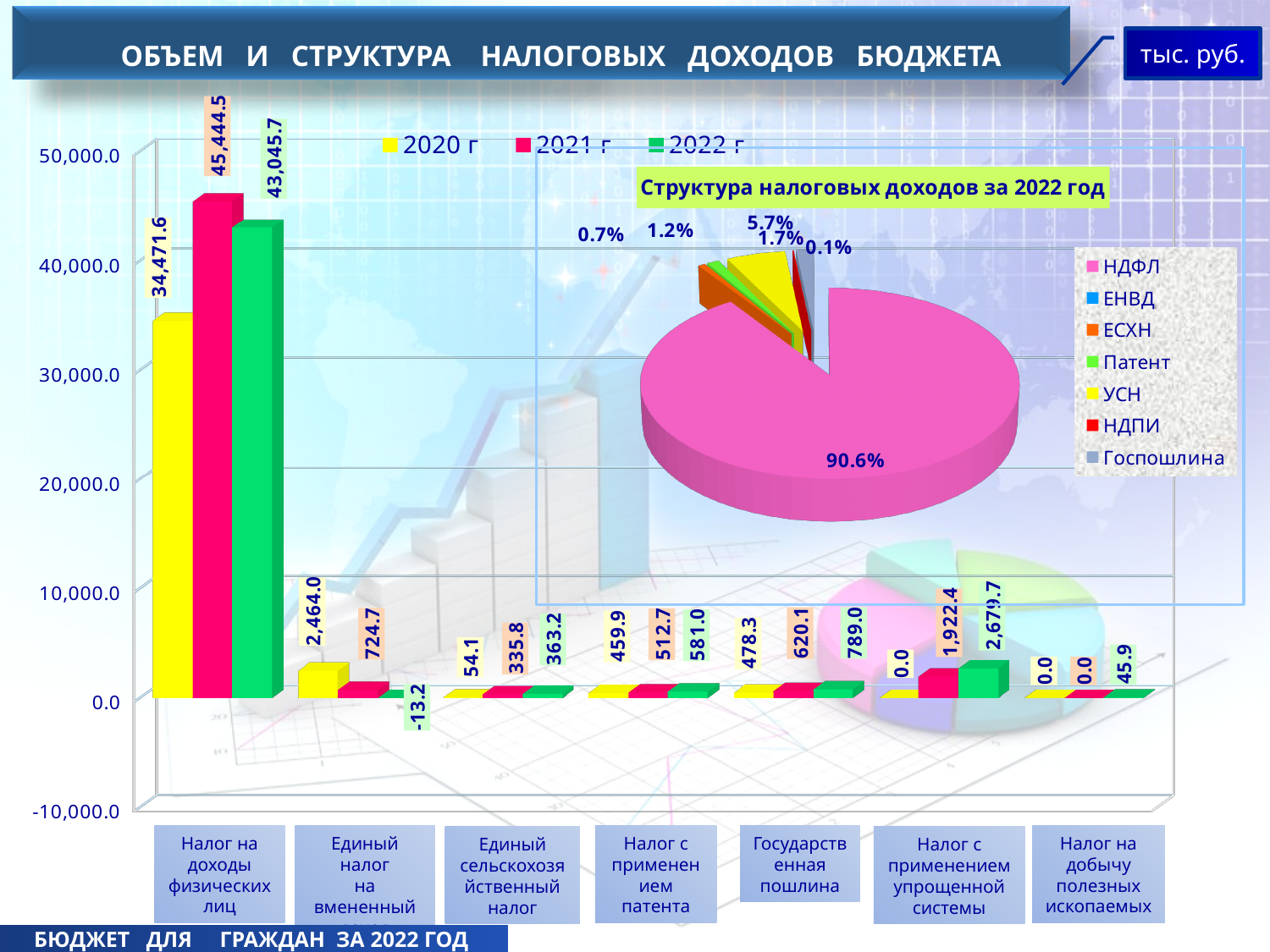
On the bar chart, what is the 2022 value for Налог с применением упрощенной системы? 2,679.7 How many series does the bar chart's legend list? 3 On the bar chart, what is the 2022 value for Единый налог на вмененный? -13.2 On the bar chart, what is the difference between the 2021 and 2020 values for Налог на доходы физических лиц? 10,972.9 On the bar chart, what is the 2020 value for Единый налог на вмененный? 2,464.0 How many entries does the legend of the pie chart Структура налоговых доходов за 2022 год list? 7 On the bar chart, how many categories are shown on the x axis? 7 On the bar chart, what is the 2021 value for Налог на доходы физических лиц? 45,444.5 On the bar chart, which category has the highest 2022 value? Налог на доходы физических лиц On the bar chart, do the values for Единый сельскохозяйственный налог rise or fall from 2020 to 2022? rise On the bar chart, which is larger for Государственная пошлина: the 2021 value or the 2022 value? 2022 value On the pie chart Структура налоговых доходов за 2022 год, what share does НДФЛ have? 90.6%